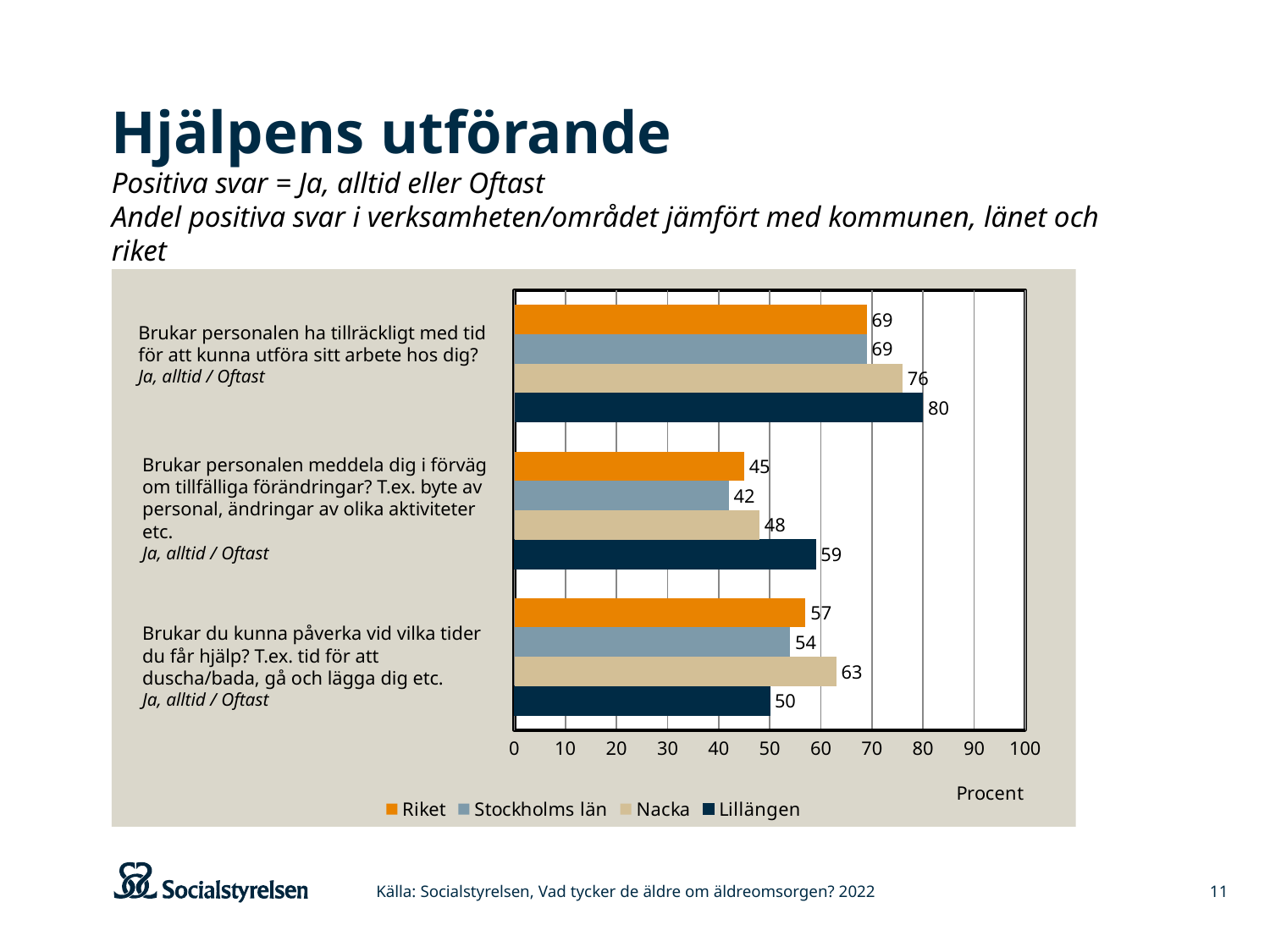
What unit is shown on the horizontal axis of the chart? Procent What kind of chart is shown on the slide? Bar chart What is the difference between Lillängen and Riket on the question "Brukar personalen ha tillräckligt med tid för att kunna utföra sitt arbete hos dig?"? 11 How many questions (categories) are shown in the chart? 3 What is the value for Stockholms län on the question "Brukar personalen meddela dig i förväg om tillfälliga förändringar?"? 42 Which is larger on the question "Brukar du kunna påverka vid vilka tider du får hjälp?": Riket or Stockholms län? Riket What is the value for Nacka on the question "Brukar du kunna påverka vid vilka tider du får hjälp?"? 63 What is the value for Lillängen on the question "Brukar personalen ha tillräckligt med tid för att kunna utföra sitt arbete hos dig?"? 80 Is the value for Nacka on the question "Brukar personalen meddela dig i förväg om tillfälliga förändringar?" greater or less than 50? less Which series has the highest value on the question "Brukar personalen meddela dig i förväg om tillfälliga förändringar?"? Lillängen How many series does the legend list? 4 Which series has the lowest value on the question "Brukar du kunna påverka vid vilka tider du får hjälp?"? Lillängen